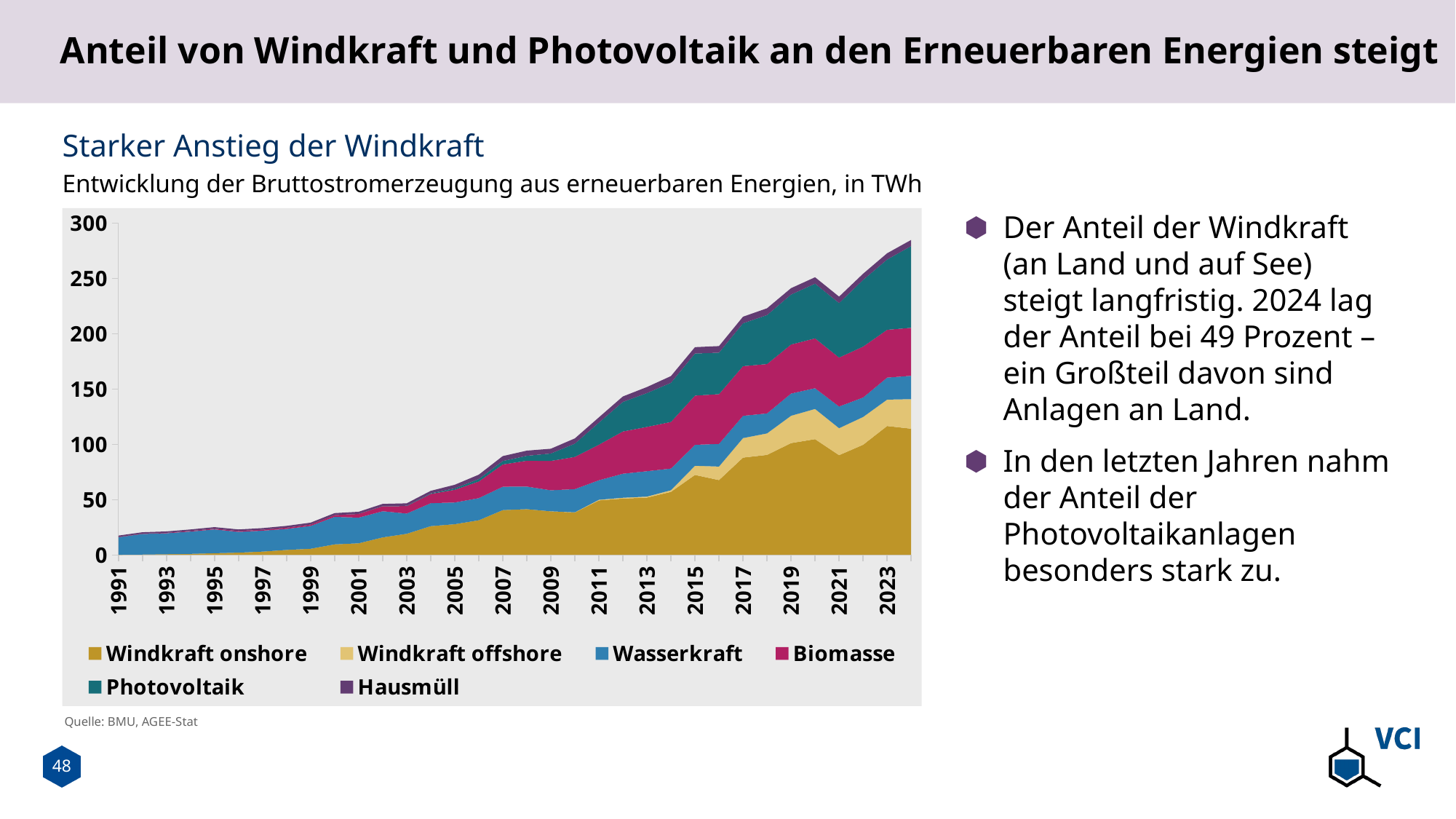
Is the value for Windkraft onshore in 2023 greater or less than 100? greater Is the total value for 2023 greater or less than 250? greater What unit is the chart's data given in, according to the subtitle? TWh How many series does the chart legend list? 6 Which series contributes the smallest share of the total in 2023? Hausmüll What kind of chart is shown on the slide? stacked area chart Is the total value for 1991 greater or less than 50? less Does the total gross electricity generation from renewables rise or fall from 1991 to 2023? rise In 2023, which is larger: Windkraft onshore or Wasserkraft? Windkraft onshore Which series contributes the largest share of the total in 2023? Windkraft onshore Which series are listed in the chart legend? Windkraft onshore, Windkraft offshore, Wasserkraft, Biomasse, Photovoltaik, Hausmüll